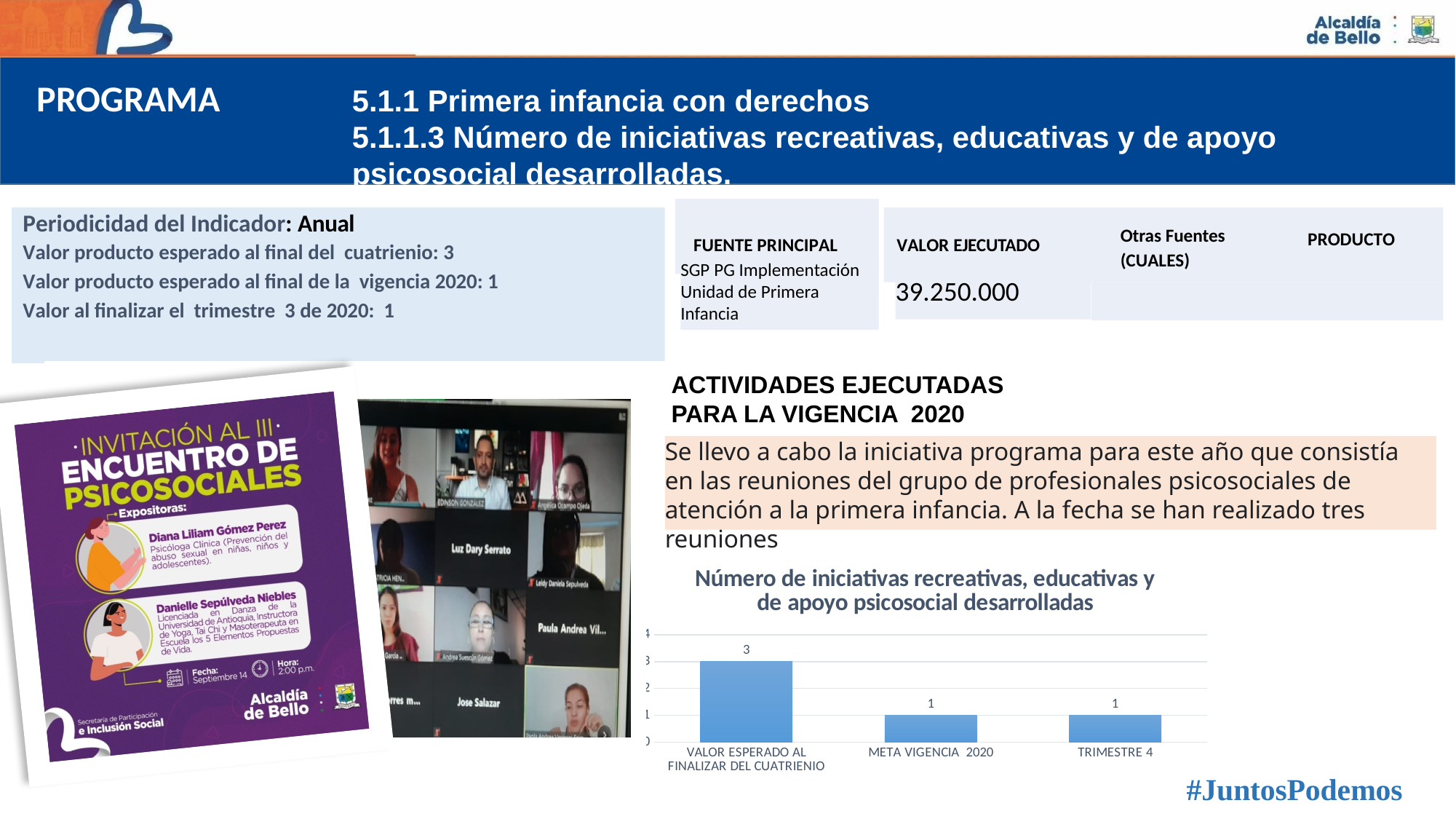
How many categories are shown on the x axis of the chart? 3 Is the value for VALOR ESPERADO AL FINALIZAR DEL CUATRIENIO greater or less than 2? greater What is the title of the chart on the slide? Número de iniciativas recreativas, educativas y de apoyo psicosocial desarrolladas Which category has the highest value in the chart? VALOR ESPERADO AL FINALIZAR DEL CUATRIENIO What is the difference between the value for VALOR ESPERADO AL FINALIZAR DEL CUATRIENIO and the value for META VIGENCIA 2020? 2 What is the value for VALOR ESPERADO AL FINALIZAR DEL CUATRIENIO in the chart? 3 What is the value for META VIGENCIA 2020 in the chart? 1 What kind of chart is shown on the slide? bar chart Which is larger, the value for VALOR ESPERADO AL FINALIZAR DEL CUATRIENIO or the value for TRIMESTRE 4? VALOR ESPERADO AL FINALIZAR DEL CUATRIENIO What is the highest value shown on the y axis of the chart? 4 What is the value for TRIMESTRE 4 in the chart? 1 Is the value for META VIGENCIA 2020 greater or less than 2? less